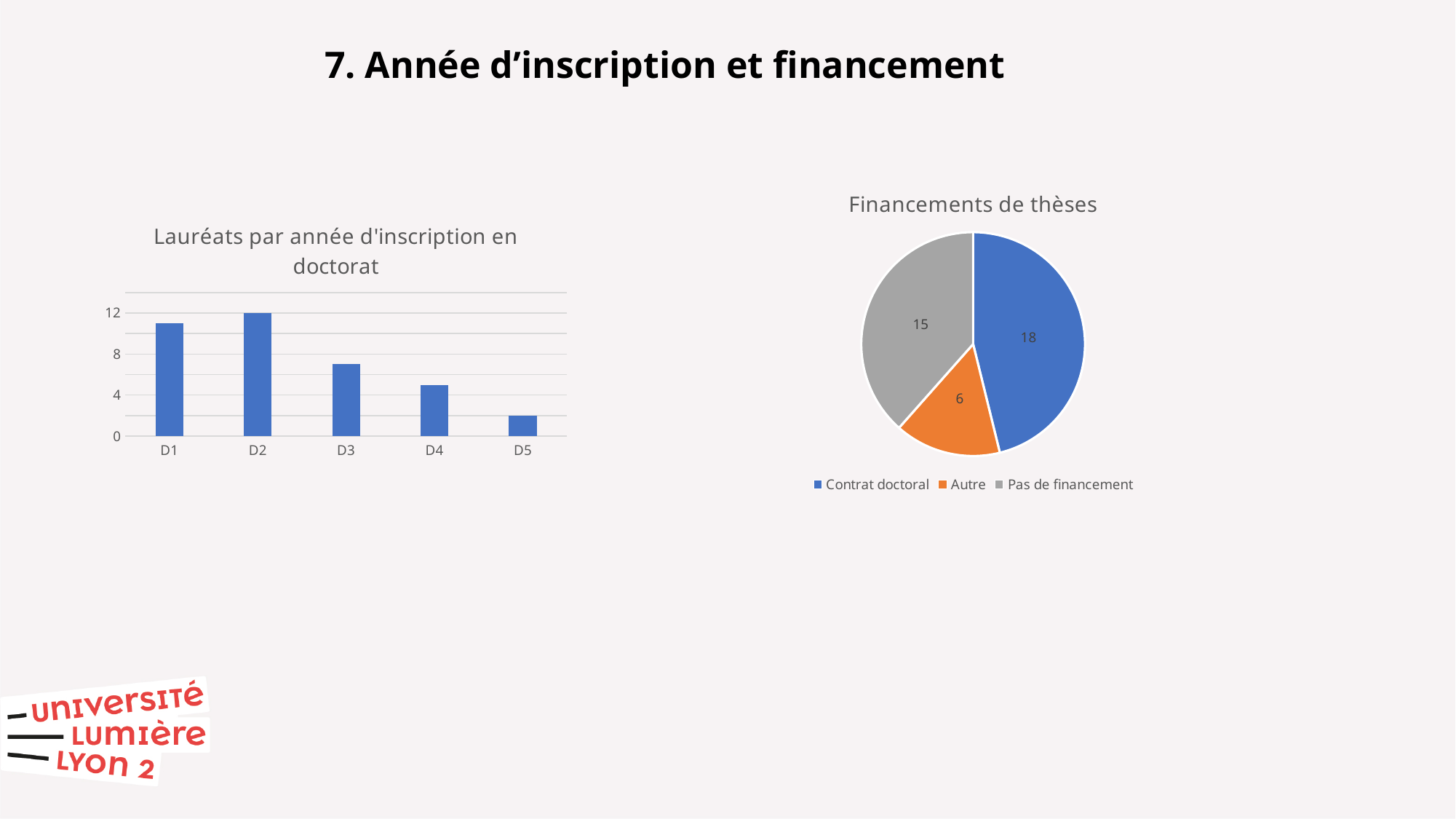
In the chart 'Lauréats par année d'inscription en doctorat', do the values rise or fall from D2 to D5? fall How many entries does the legend of the pie chart 'Financements de thèses' list? 3 In the chart 'Lauréats par année d'inscription en doctorat', how many categories are shown on the x axis? 5 In the pie chart 'Financements de thèses', what is the value for Pas de financement? 15 In the pie chart 'Financements de thèses', what is the difference between Contrat doctoral and Autre? 12 In the chart 'Lauréats par année d'inscription en doctorat', which is larger, the value for D1 or the value for D3? D1 In the chart 'Lauréats par année d'inscription en doctorat', is the value for D1 greater or less than 8? greater In the chart 'Lauréats par année d'inscription en doctorat', which year has the highest number of lauréats? D2 In the pie chart 'Financements de thèses', what is the value for Contrat doctoral? 18 In the chart 'Lauréats par année d'inscription en doctorat', is the value for D5 greater or less than 4? less What kind of chart is 'Lauréats par année d'inscription en doctorat'? bar chart In the chart 'Lauréats par année d'inscription en doctorat', which year has the lowest number of lauréats? D5